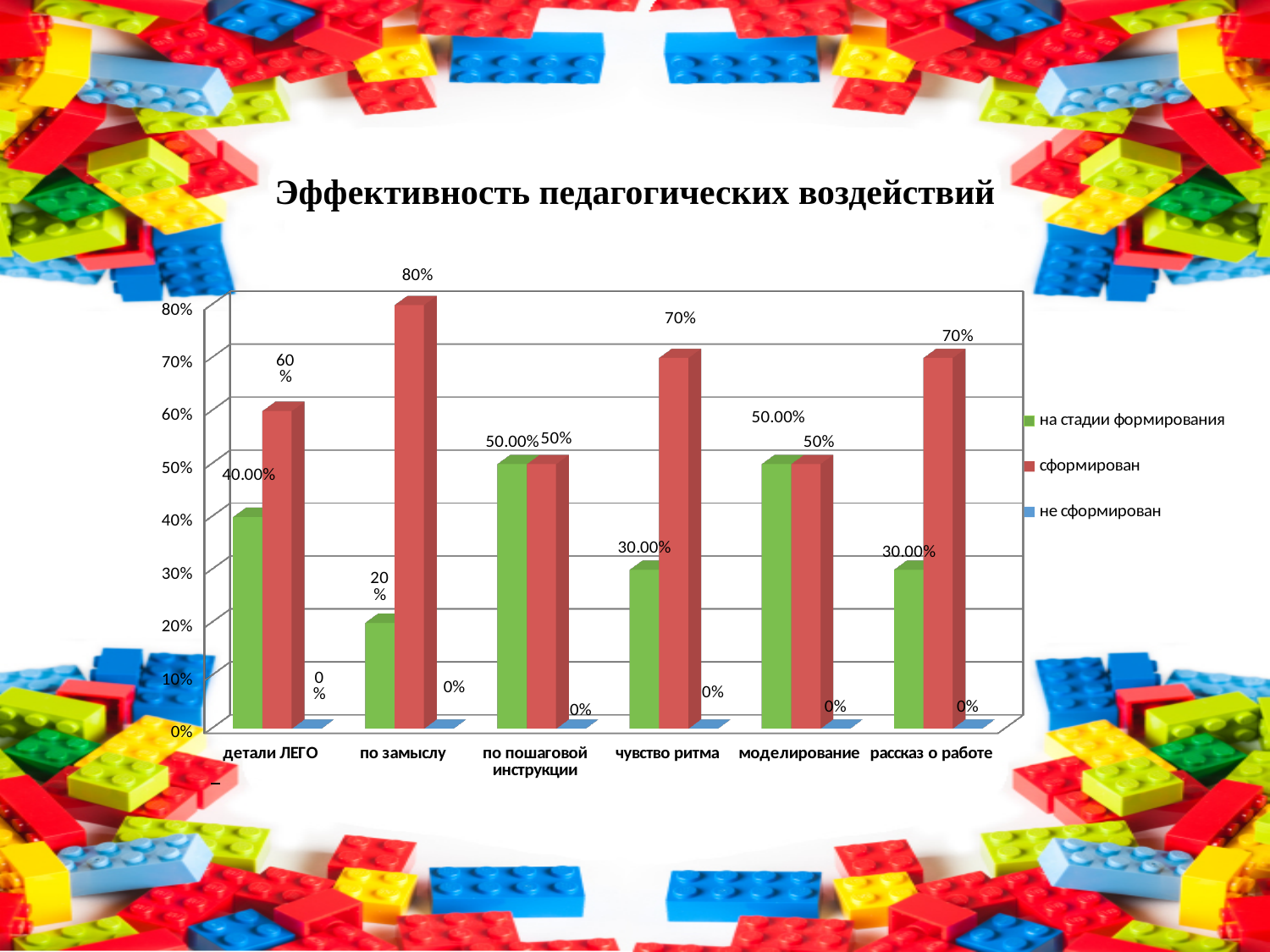
In the 'детали ЛЕГО' category, which is larger: 'сформирован' or 'на стадии формирования'? сформирован Which category has the highest value for 'сформирован'? по замыслу What is the value for 'на стадии формирования' in the 'детали ЛЕГО' category? 40.00% What is the value for 'сформирован' in the 'рассказ о работе' category? 70% What kind of chart is shown on the slide? bar chart Which category has the lowest value for 'на стадии формирования'? по замыслу What is the title of the chart? Эффективность педагогических воздействий What is the value for 'сформирован' in the 'по замыслу' category? 80% How many categories are shown on the x axis? 6 What is the difference between the 'сформирован' and 'на стадии формирования' values in the 'по замыслу' category? 60% How many series does the legend list? 3 What is the value for 'на стадии формирования' in the 'чувство ритма' category? 30.00%